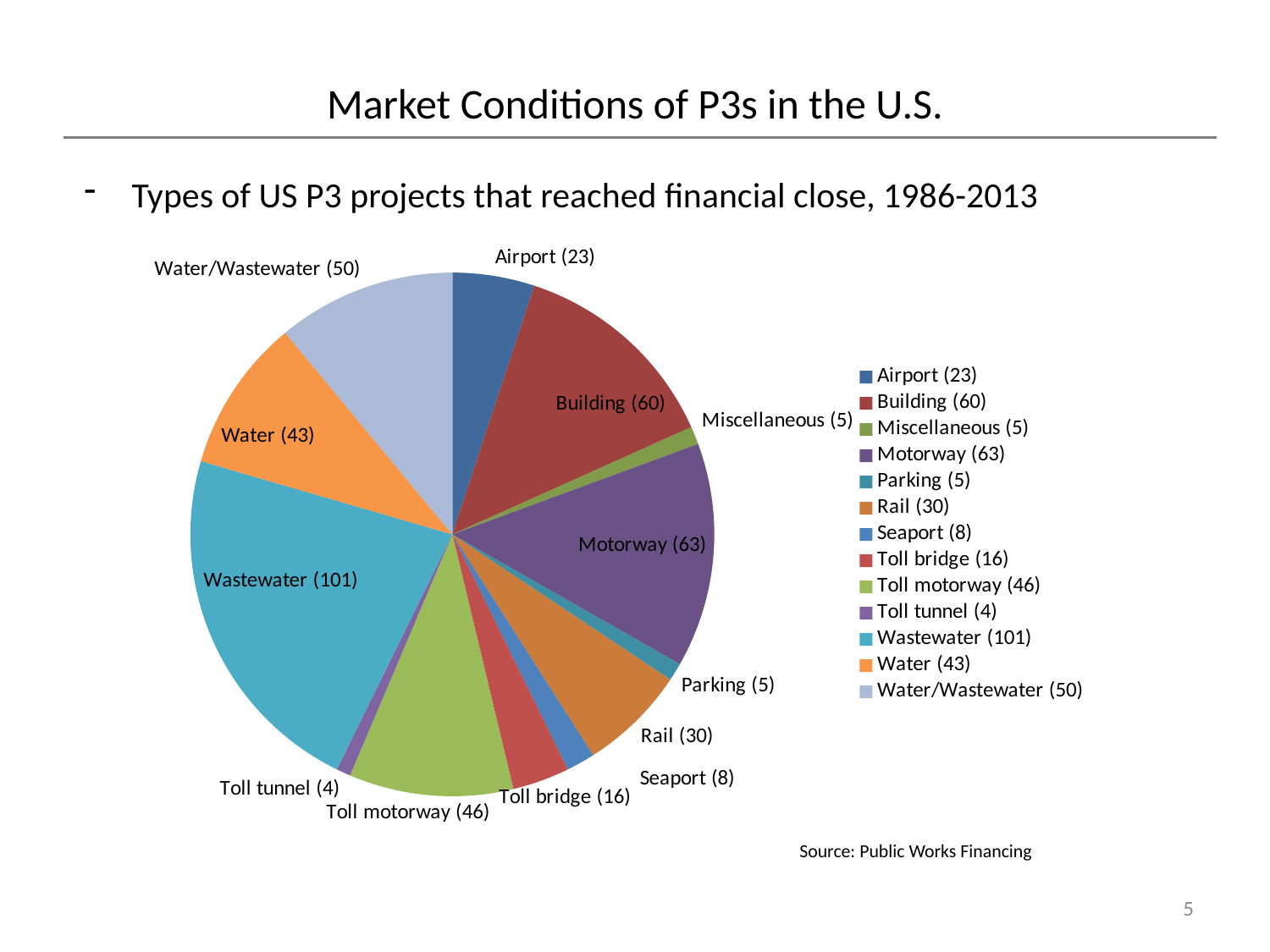
What kind of chart is shown on the slide? Pie chart How many categories are shown in the pie chart? 13 What is the difference between the Motorway value and the Airport value? 40 How many projects does the Motorway slice represent? 63 What is the difference between the Building value and the Water value? 17 What source is cited for the chart? Public Works Financing What is the value shown for Rail? 30 Which category has the largest slice of the pie? Wastewater (101) Which is larger, Water/Wastewater or Toll motorway? Water/Wastewater What is the value shown for Seaport? 8 Which category has the smallest slice of the pie? Toll tunnel (4) What is the total number of projects across all slices of the pie? 454